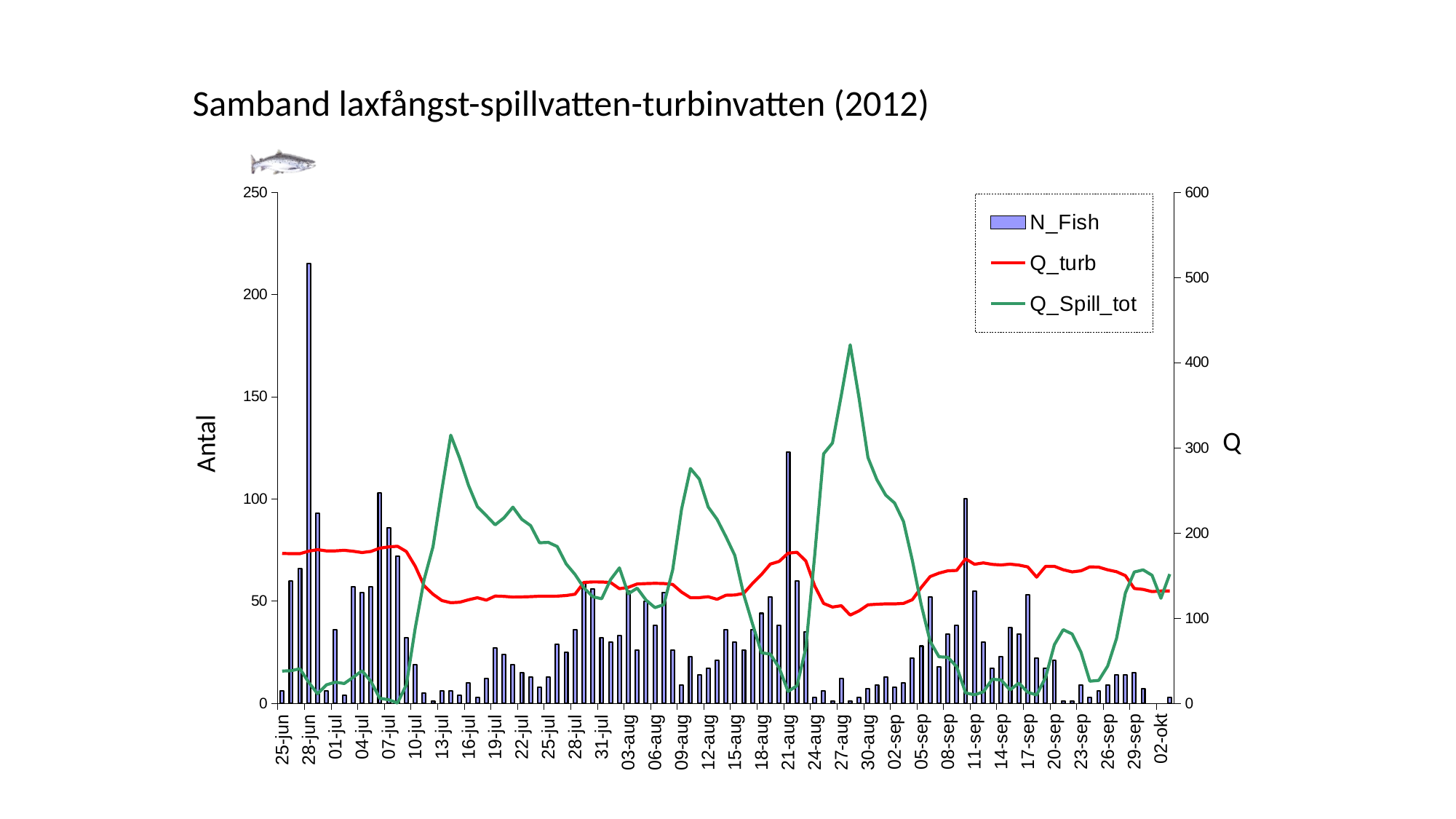
Which series in the legend is drawn in red? Q_turb What is the title of the chart on the slide? Samband laxfångst-spillvatten-turbinvatten (2012) Is the value of Q_turb around 27-aug greater or less than 200 on the right axis? less Is the peak of Q_Spill_tot around 27-aug greater or less than 300 on the right axis? greater How many series does the chart legend list? 3 Is the tallest N_Fish bar greater or less than 200 on the left axis? greater What kind of chart is shown on the slide? Combined bar and line chart Around 27-aug, which series has the higher value: Q_turb or Q_Spill_tot? Q_Spill_tot Does Q_Spill_tot rise or fall between 13-jul and 28-jul? fall How many date labels are shown on the x axis? 34 Which is higher: the Q_Spill_tot peak around 13-jul or the Q_Spill_tot peak around 27-aug? 27-aug Which series reaches the highest value on the right-hand Q axis? Q_Spill_tot